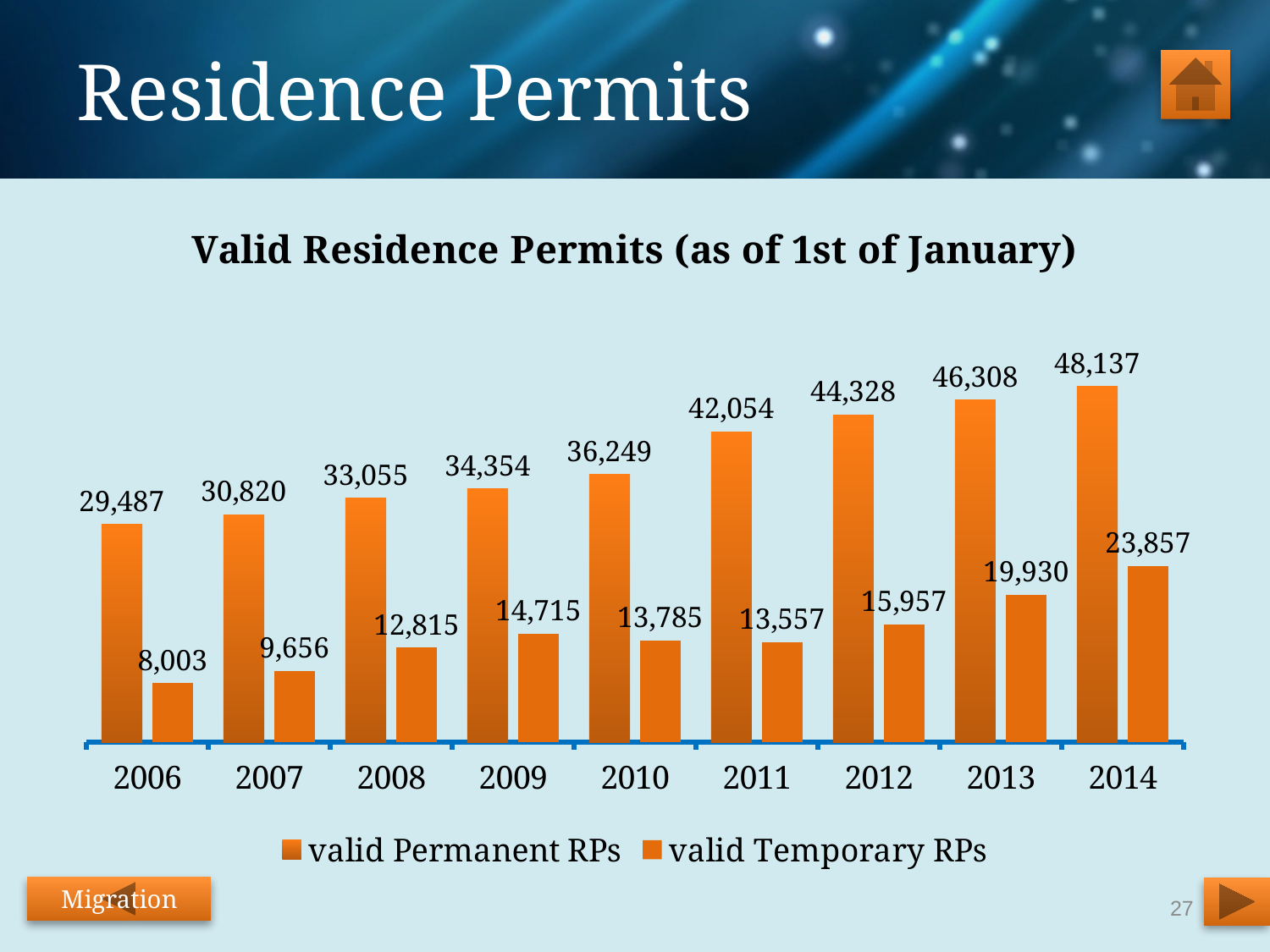
What is the difference between valid Permanent RPs and valid Temporary RPs in 2014? 24,280 Which is larger, valid Temporary RPs in 2010 or in 2011? 2010 What kind of chart is shown on the slide? Bar chart What is the value for valid Temporary RPs in 2006? 8,003 How many series does the legend list? 2 How many years are shown on the x axis? 9 By how much did valid Permanent RPs increase from 2006 to 2014? 18,650 Which year has the highest value for valid Permanent RPs? 2014 What is the value for valid Permanent RPs in 2010? 36,249 Do the values for valid Permanent RPs rise or fall from 2006 to 2014? Rise What is the value for valid Temporary RPs in 2013? 19,930 Which year has the lowest value for valid Temporary RPs? 2006